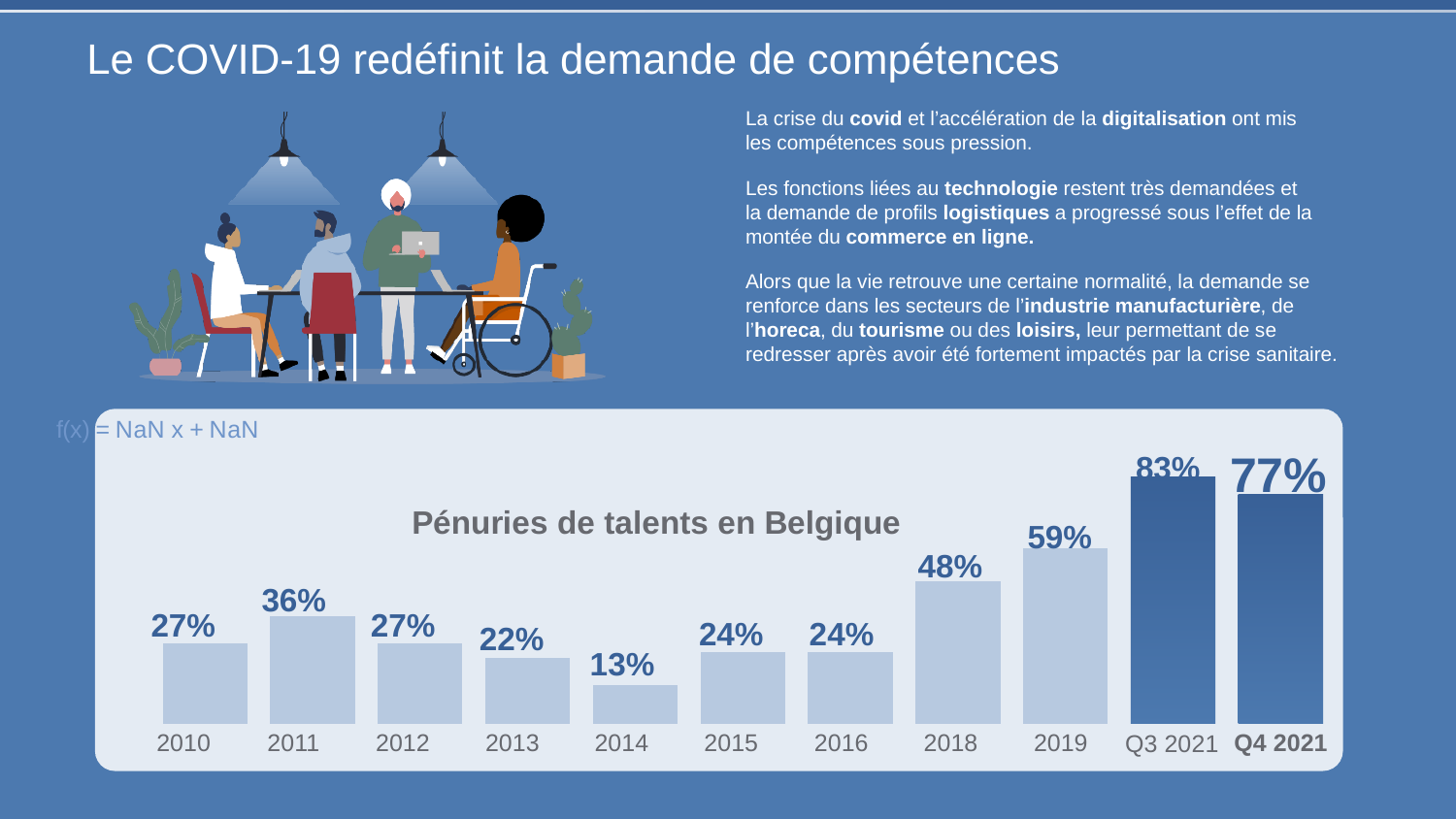
Which is larger in the 'Pénuries de talents en Belgique' chart, the value for 2011 or the value for 2013? 2011 Which category has the lowest value in the 'Pénuries de talents en Belgique' chart? 2014 What is the value for Q4 2021 in the 'Pénuries de talents en Belgique' chart? 77% Do the values in the 'Pénuries de talents en Belgique' chart rise or fall from 2014 to Q3 2021? Rise What is the difference between the values for 2019 and 2018 in the 'Pénuries de talents en Belgique' chart? 11% How many categories are shown on the x axis of the 'Pénuries de talents en Belgique' chart? 11 What is the title of the chart on the slide? Pénuries de talents en Belgique What is the value for 2019 in the 'Pénuries de talents en Belgique' chart? 59% What kind of chart is 'Pénuries de talents en Belgique'? Bar chart What is the value for 2014 in the 'Pénuries de talents en Belgique' chart? 13% Which category has the highest value in the 'Pénuries de talents en Belgique' chart? Q3 2021 What is the difference between the values for Q3 2021 and Q4 2021 in the 'Pénuries de talents en Belgique' chart? 6%